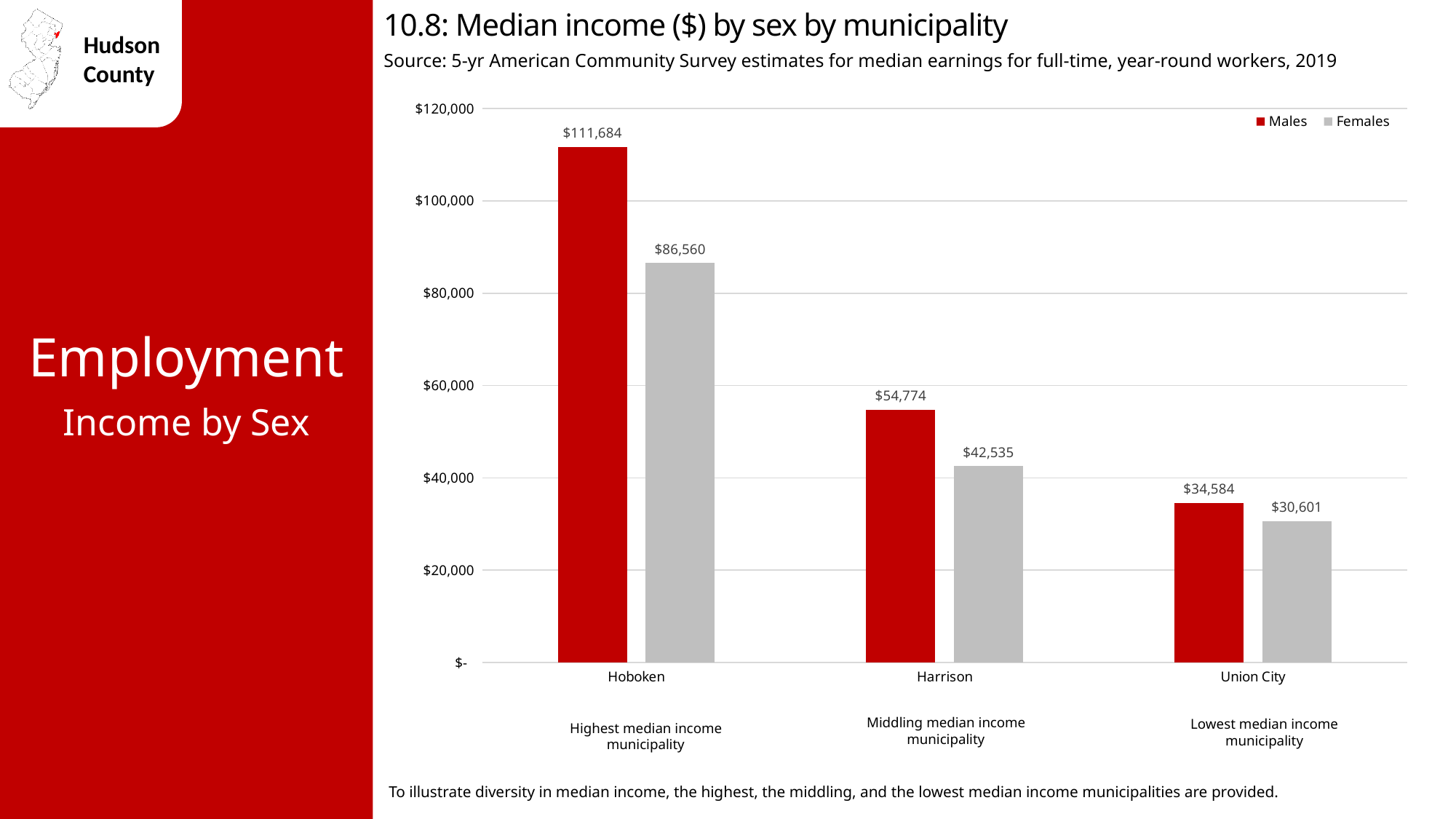
What is the difference between male and female median income in Hoboken? $25,124 Which municipality has the lowest median income for females? Union City What is the median income for females in Harrison? $42,535 Which is larger: the female median income in Hoboken or the male median income in Harrison? Female median income in Hoboken Is the male median income in Harrison greater or less than $60,000? less Which municipality has the highest median income for males? Hoboken What kind of chart is shown on the slide? Bar chart What is the median income for females in Union City? $30,601 What is the median income for males in Hoboken? $111,684 What is the difference between male and female median income in Union City? $3,983 How many municipalities are shown on the chart? 3 How many series does the legend list? 2